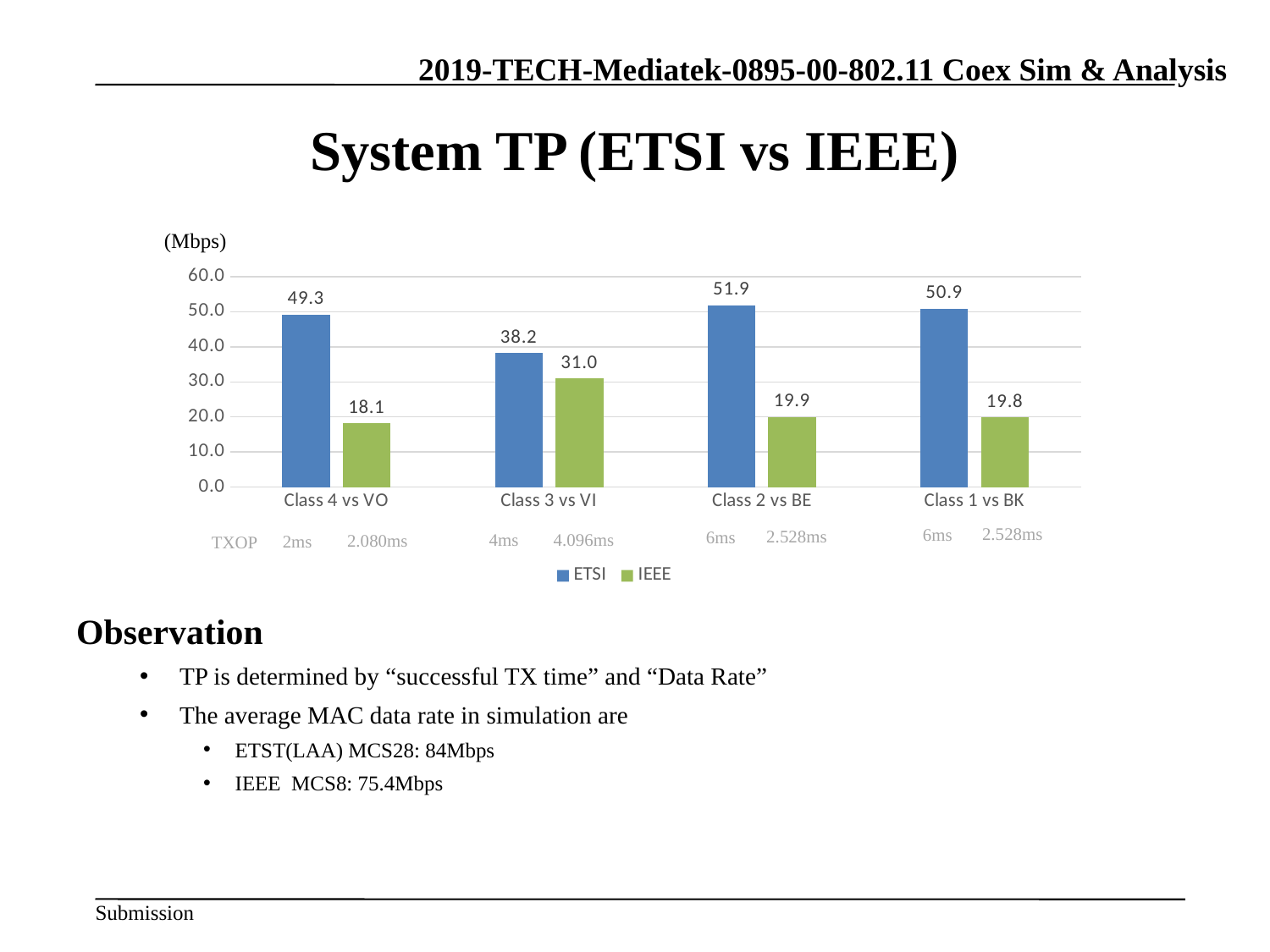
What is the IEEE value for Class 1 vs BK? 19.8 What is the difference between the ETSI and IEEE values for Class 4 vs VO? 31.2 How many categories are shown on the x axis? 4 Is the ETSI value for Class 3 vs VI greater or less than 40.0? less Which is larger for Class 3 vs VI, the ETSI value or the IEEE value? ETSI Which category has the lowest IEEE value? Class 4 vs VO How many series does the legend list? 2 What is the IEEE value for Class 3 vs VI? 31.0 What unit is shown on the y axis of the chart? Mbps What kind of chart is shown on the slide? bar chart What is the ETSI value for Class 4 vs VO? 49.3 Which category has the highest ETSI value? Class 2 vs BE